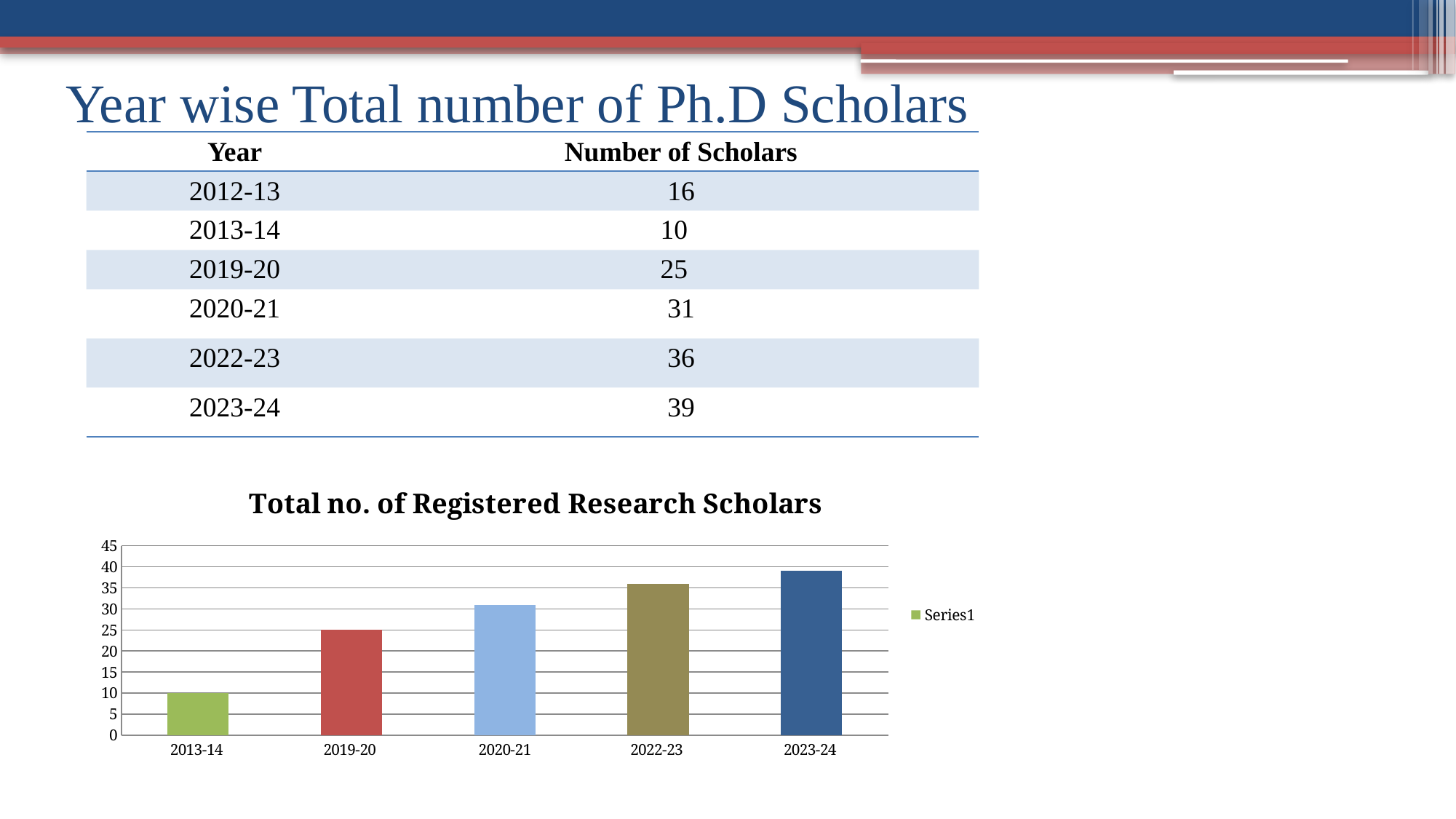
What is the title of the chart? Total no. of Registered Research Scholars Which year has the lowest bar in the chart? 2013-14 What is the difference between the values for 2019-20 and 2013-14 in the chart? 15 Do the values rise or fall from 2013-14 to 2023-24 along the x axis? rise How many series does the chart legend list? 1 What type of chart is shown on the slide? bar chart Which year has the highest bar in the chart? 2023-24 How many bars (categories) does the chart show? 5 Is the value for 2023-24 greater or less than 40? less What is the value for 2013-14 in the chart? 10 Is the value for 2020-21 greater or less than 30? greater What is the value for 2019-20 in the chart? 25